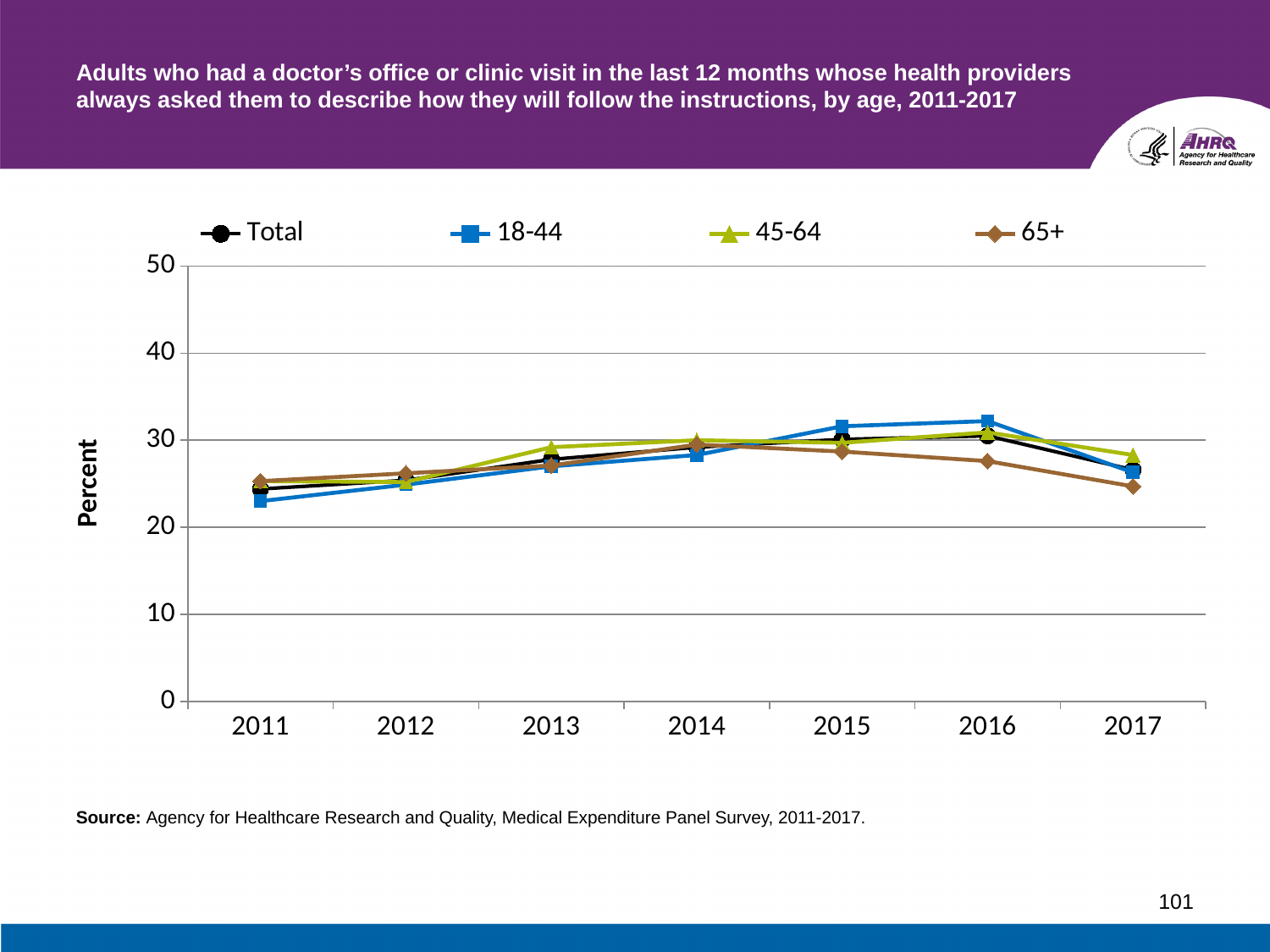
What kind of chart is shown on the slide? Line chart What is the label on the y axis? Percent Is the value for the Total series in 2015 greater or less than 40? less How many years are plotted along the x axis? 7 Is the value for the 65+ group in 2017 greater or less than 30? less Which series has the lowest value in 2011? 18-44 Does the value for the 65+ group rise or fall from 2014 to 2017? Fall Is the value for the 18-44 group in 2016 greater or less than 30? greater How many series does the legend list? 4 In 2016, which is larger: the value for 18-44 or the value for 65+? 18-44 Which series has the lowest value in 2017? 65+